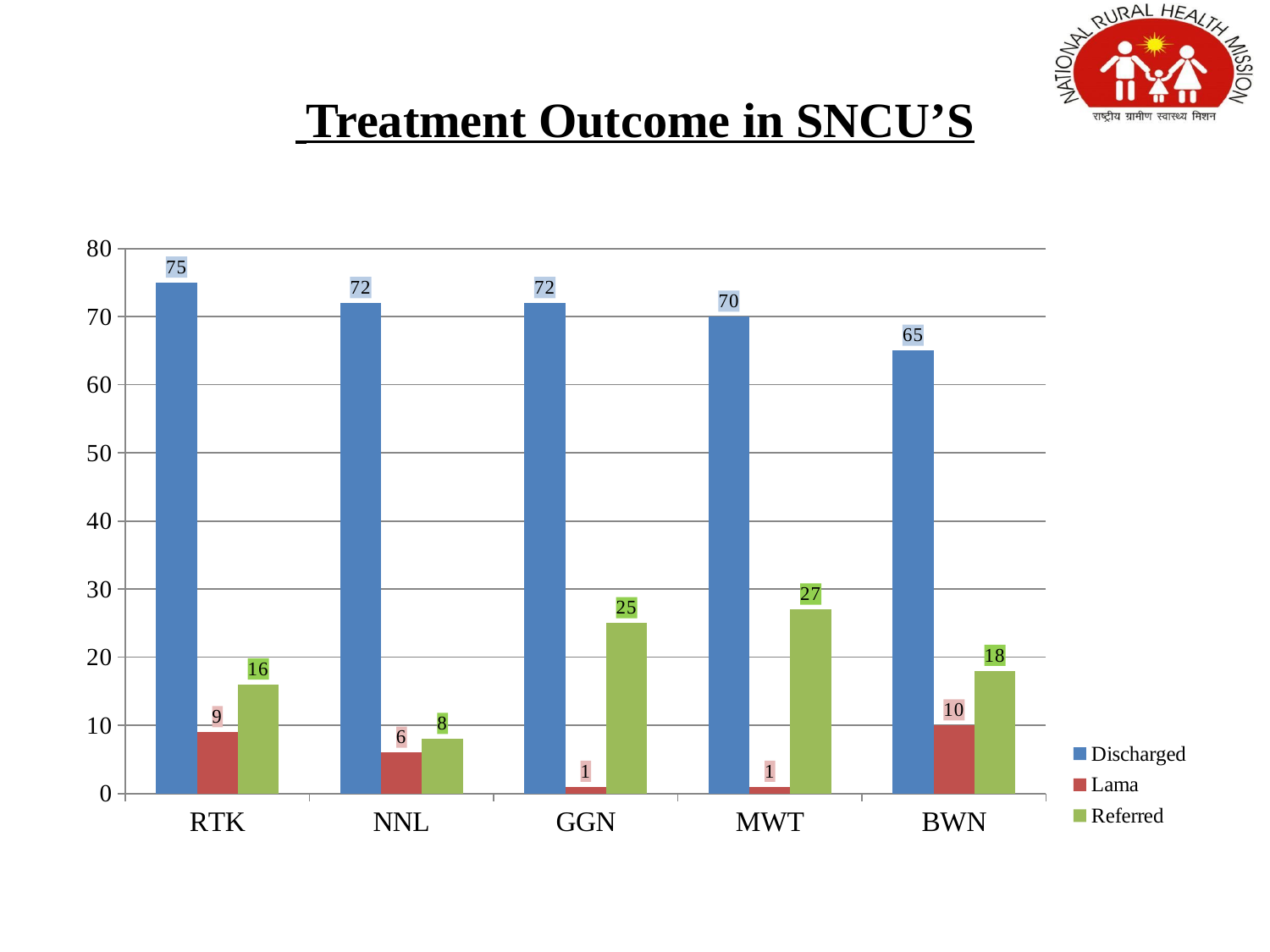
What is the Lama value for BWN? 10 What is the title of the chart? Treatment Outcome in SNCU’S Which category has the highest Discharged value? RTK What kind of chart is shown on the slide? bar chart Which is larger, the Referred value for GGN or the Referred value for BWN? GGN Which category has the lowest Referred value? NNL What is the Referred value for MWT? 27 How many series does the legend list? 3 What is the difference between the Discharged values for RTK and BWN? 10 Is the Discharged value for BWN greater or less than 70? less What is the Discharged value for RTK? 75 How many categories are shown on the x axis? 5